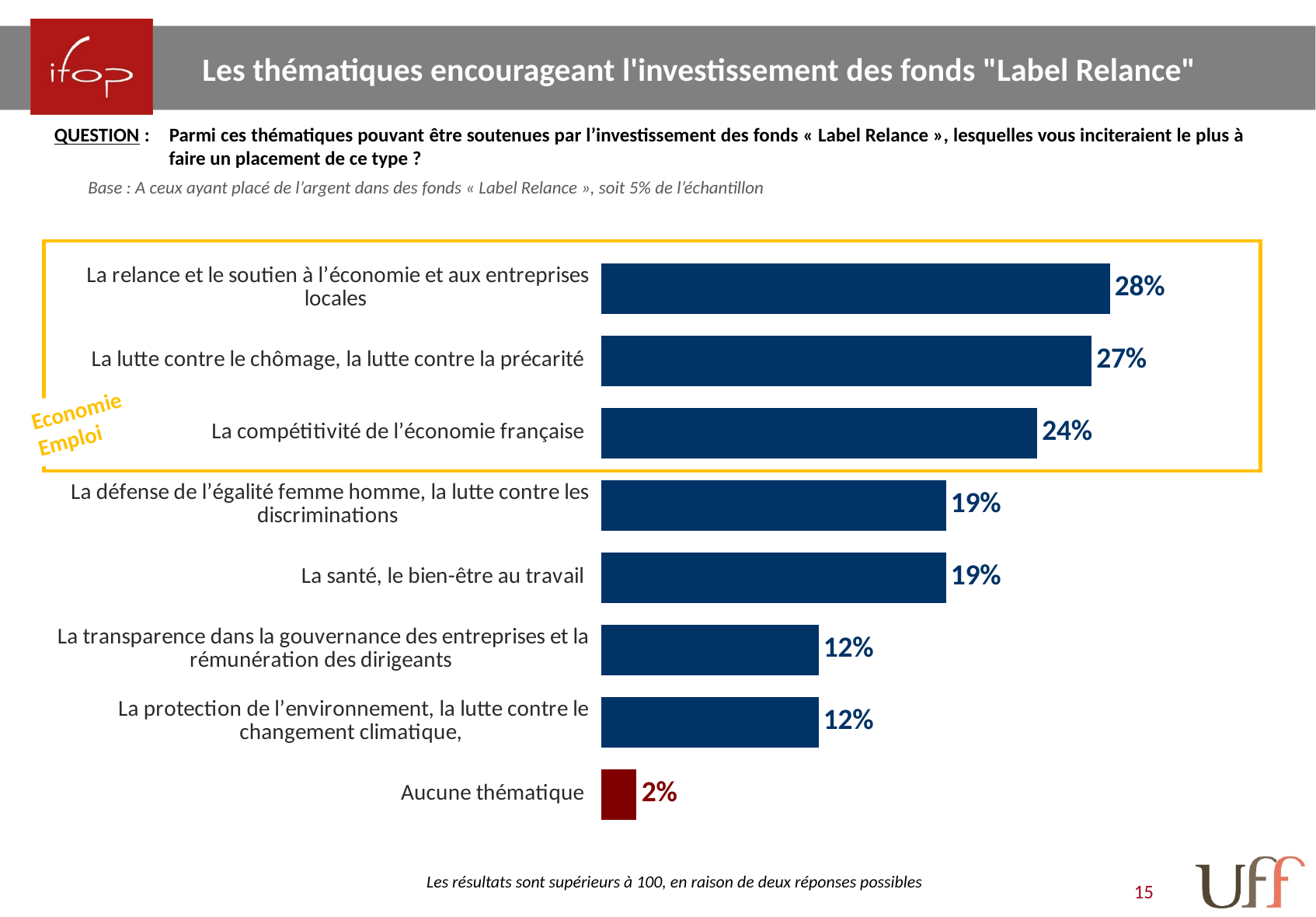
What kind of chart is shown on the slide? Bar chart What is the difference between "La lutte contre le chômage, la lutte contre la précarité" and "La santé, le bien-être au travail"? 8 percentage points Which bar is shown in a different colour (dark red) from the others? Aucune thématique Which category has the lowest value on the chart? Aucune thématique How many categories are plotted on the chart? 8 Which is larger: "La compétitivité de l'économie française" or "La transparence dans la gouvernance des entreprises et la rémunération des dirigeants"? La compétitivité de l'économie française Which theme has the highest percentage? La relance et le soutien à l'économie et aux entreprises locales What percentage is shown for "La relance et le soutien à l'économie et aux entreprises locales"? 28% What value is shown for "La protection de l'environnement, la lutte contre le changement climatique"? 12% What percentage is shown for "Aucune thématique"? 2% What label is written in yellow next to the highlighted box around the top three bars? Economie Emploi What value is shown for "La compétitivité de l'économie française"? 24%